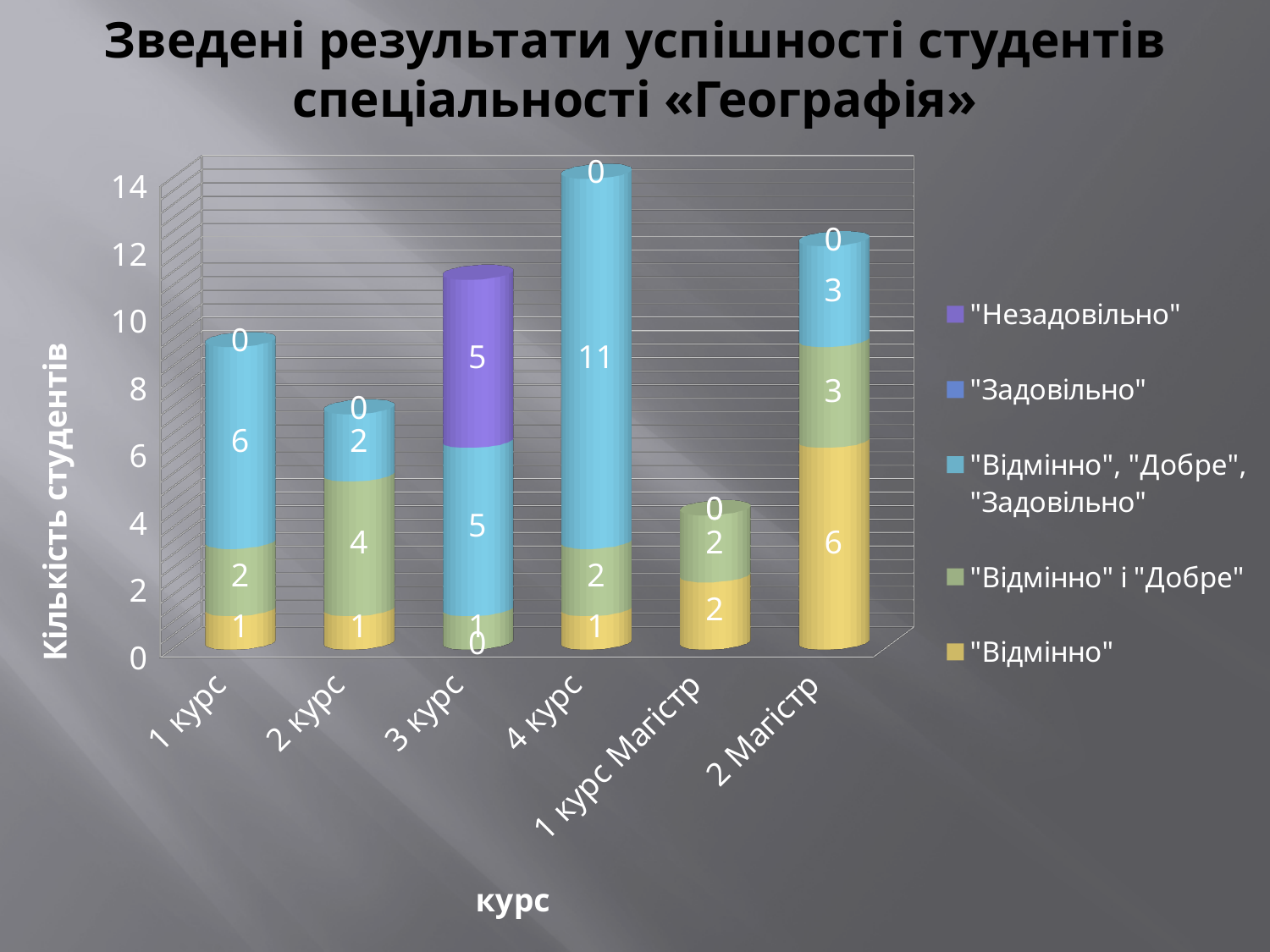
What is the label of the y axis? Кількість студентів What is the difference between the "Відмінно" values for 2 Магістр and 1 курс Магістр? 4 What kind of chart is shown on the slide? stacked bar chart What is the value of "Незадовільно" for 3 курс? 5 Which category has the tallest stacked bar? 4 курс Which category has the shortest stacked bar? 1 курс Магістр What is the value of "Відмінно" for 2 Магістр? 6 What is the total of the stacked bar for 1 курс? 9 How many categories are shown on the x axis? 6 What is the value of "Відмінно", "Добре", "Задовільно" for 4 курс? 11 What is the value of "Відмінно" і "Добре" for 2 курс? 4 How many series does the legend list? 5